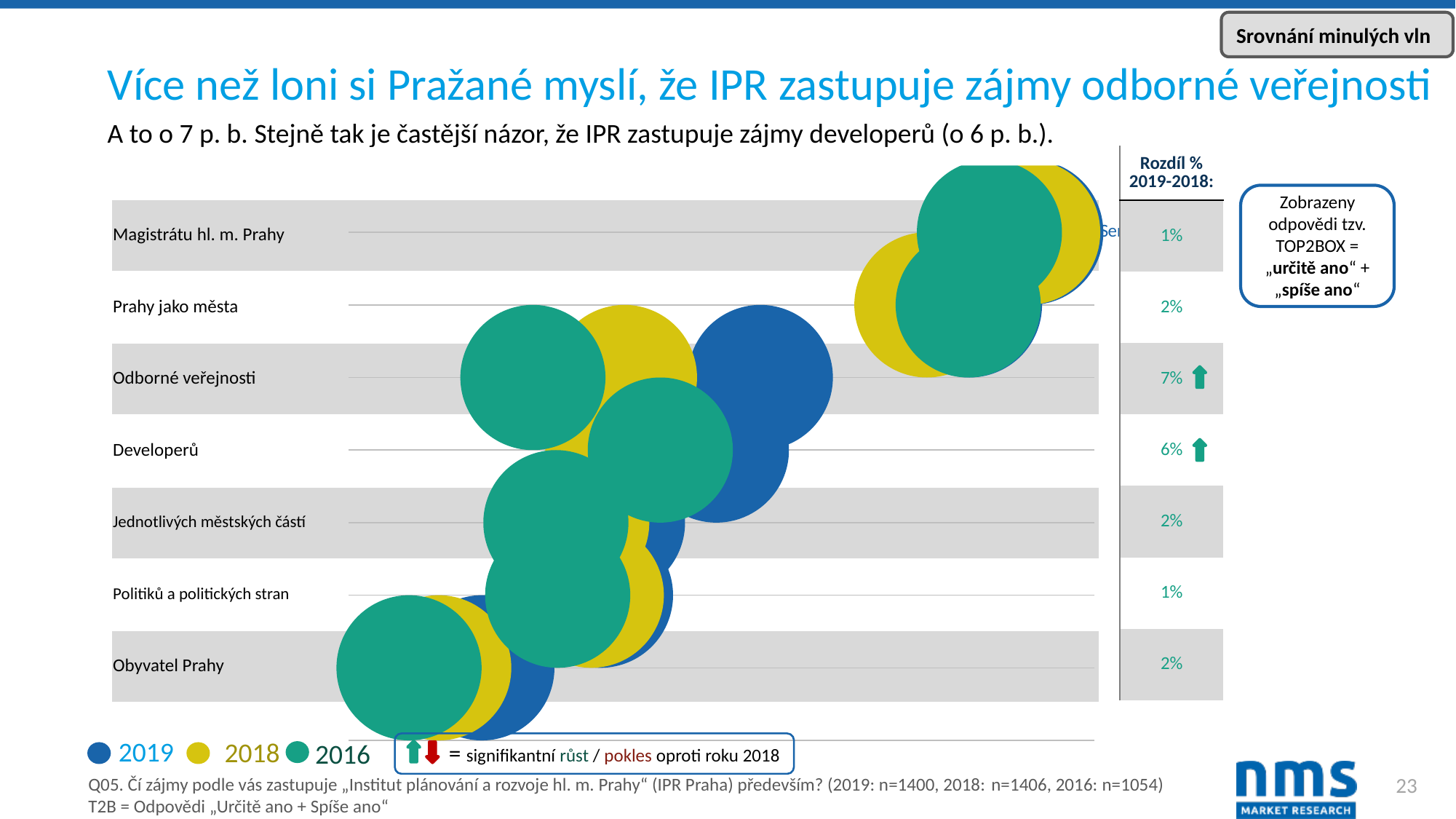
How many categories are listed on the chart's vertical axis? 7 What colour represents the 2019 series in the chart legend? Blue What is the 'Rozdíl % 2019-2018' value shown for Odborné veřejnosti? 7% Which category has the largest 'Rozdíl % 2019-2018' value? Odborné veřejnosti What is the 'Rozdíl % 2019-2018' value shown for Magistrátu hl. m. Prahy? 1% Which categories are marked with a green arrow indicating a significant increase compared to 2018? Odborné veřejnosti and Developerů What is the 'Rozdíl % 2019-2018' value shown for Politiků a politických stran? 1% What is the 'Rozdíl % 2019-2018' value shown for Developerů? 6% How many series does the chart legend list? 3 What is the 'Rozdíl % 2019-2018' value shown for Obyvatel Prahy? 2% Which years are listed in the chart legend? 2019, 2018, 2016 Which has the larger 'Rozdíl % 2019-2018' value, Odborné veřejnosti or Developerů? Odborné veřejnosti